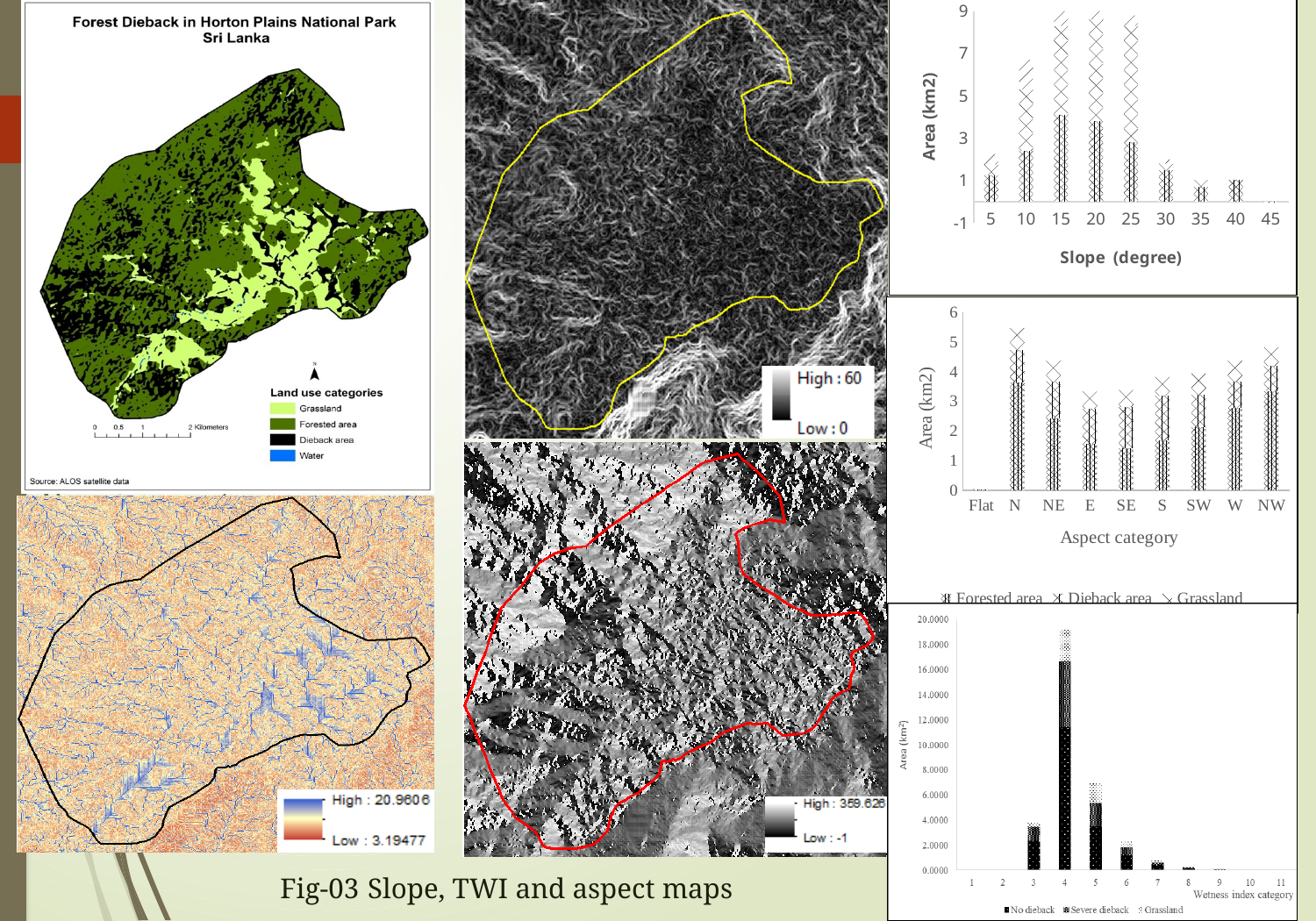
In the bottom-right chart (Wetness index category), which wetness index category has the highest total area? 4 In the middle-right chart (Aspect category), how many series does the legend list? 3 In the bottom-right chart (Wetness index category), is the total value for category 4 greater or less than 18.0000? greater In the middle-right chart (Aspect category), which aspect category has the lowest total area? Flat In the top-right chart (Slope (degree)), is the total value for slope 15 greater or less than 7? greater In the middle-right chart (Aspect category), which aspect category has the highest total area? N What kind of chart is the top-right chart with the x axis labelled Slope (degree)? bar chart In the top-right chart (Slope (degree)), which slope category has the lowest total area? 45 In the middle-right chart (Aspect category), is the total value for E greater or less than 4? less In the bottom-right chart (Wetness index category), what are the three series listed in the legend? No dieback, Severe dieback, Grassland In the top-right chart (Slope (degree)), how many slope categories are shown on the x axis? 9